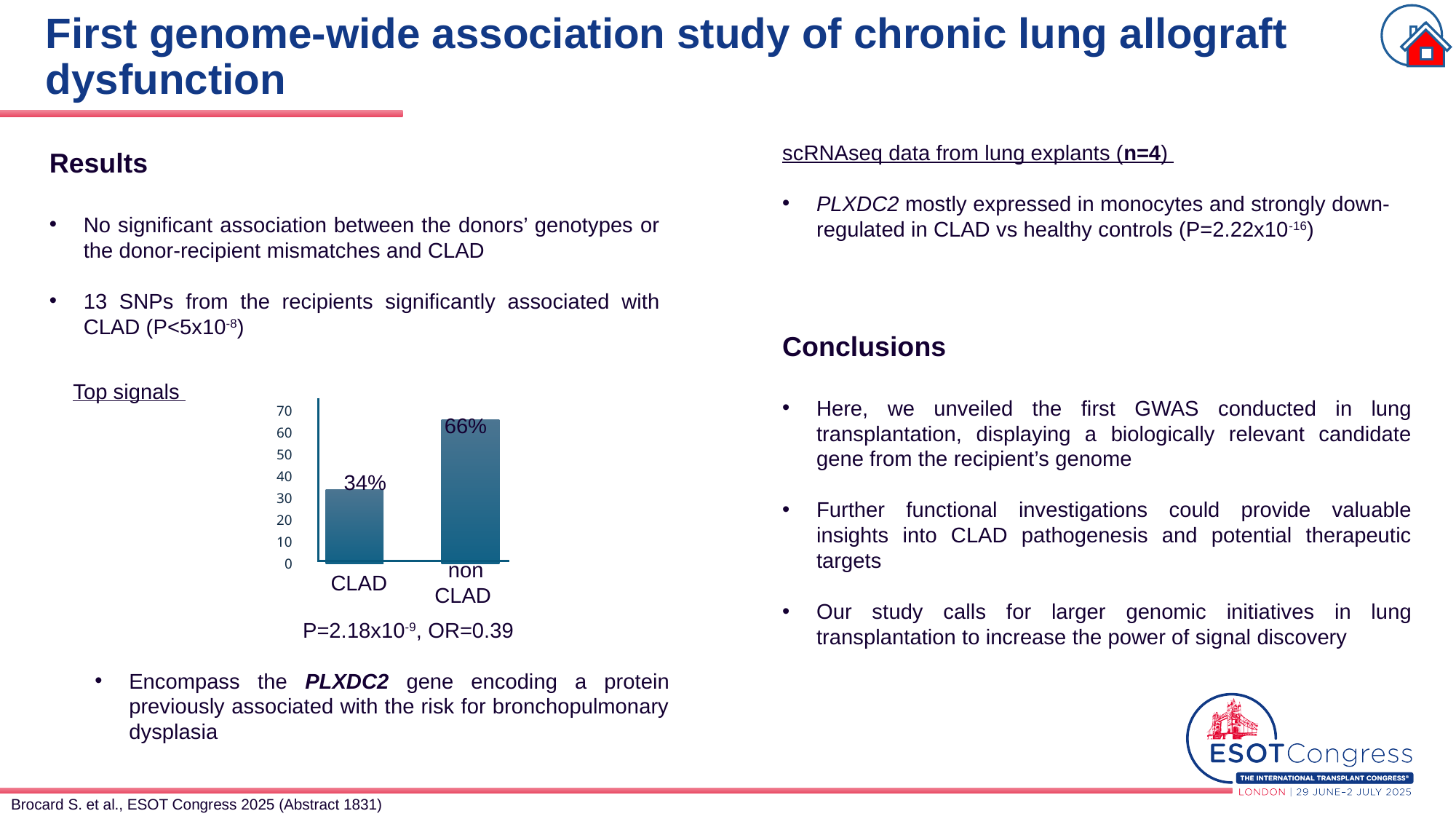
What kind of chart is shown under 'Top signals'? bar chart Is the value for CLAD larger or smaller than the value for non CLAD? smaller Is the value for non CLAD greater or less than 50? greater Which category has the higher value in the bar chart? non CLAD What P value and odds ratio are printed below the bar chart? P=2.18x10-9, OR=0.39 What is the difference between the non CLAD and CLAD values in the bar chart? 32% Which category has the lower value in the bar chart? CLAD Is the value for CLAD greater or less than 40? less What is the value shown for non CLAD in the bar chart? 66% How many categories are shown in the bar chart? 2 What is the maximum value shown on the y axis of the bar chart? 70 What is the value shown for CLAD in the bar chart? 34%